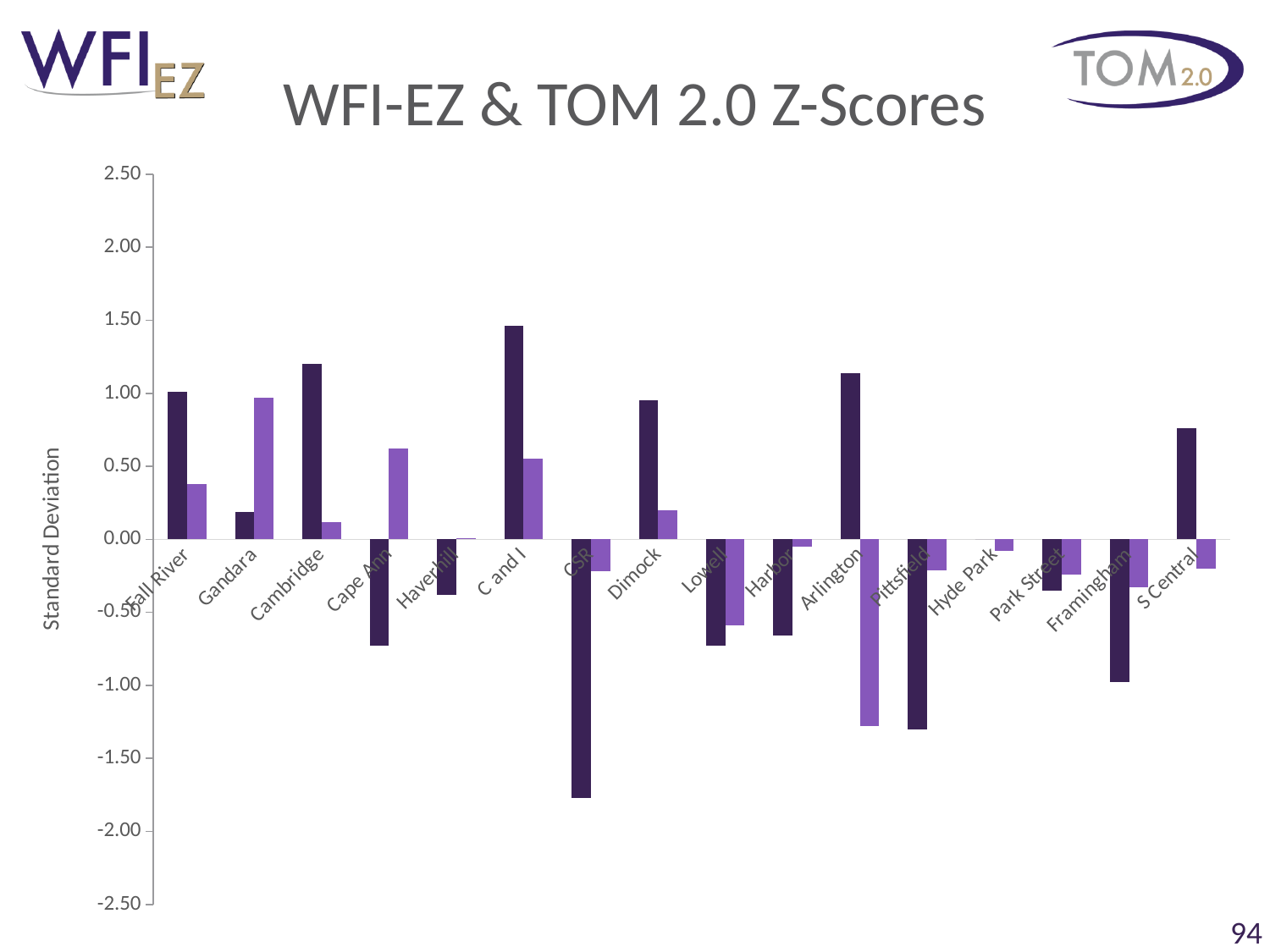
What is the label on the vertical axis of the chart? Standard Deviation Is the dark purple bar for CSR greater or less than -1.50? less How many categories (sites) are shown along the x axis of the chart? 16 Which category has the lowest dark purple bar? CSR Is the dark purple bar for C and I greater or less than 1.00? greater For Gandara, which bar is larger, the dark purple bar or the light purple bar? the light purple bar Which category has the highest light purple bar? Gandara Is the light purple bar for Arlington greater or less than -1.00? less Which category has the lowest light purple bar? Arlington Which category has the highest dark purple bar? C and I What is the title of the chart? WFI-EZ & TOM 2.0 Z-Scores What kind of chart is shown on the slide? bar chart